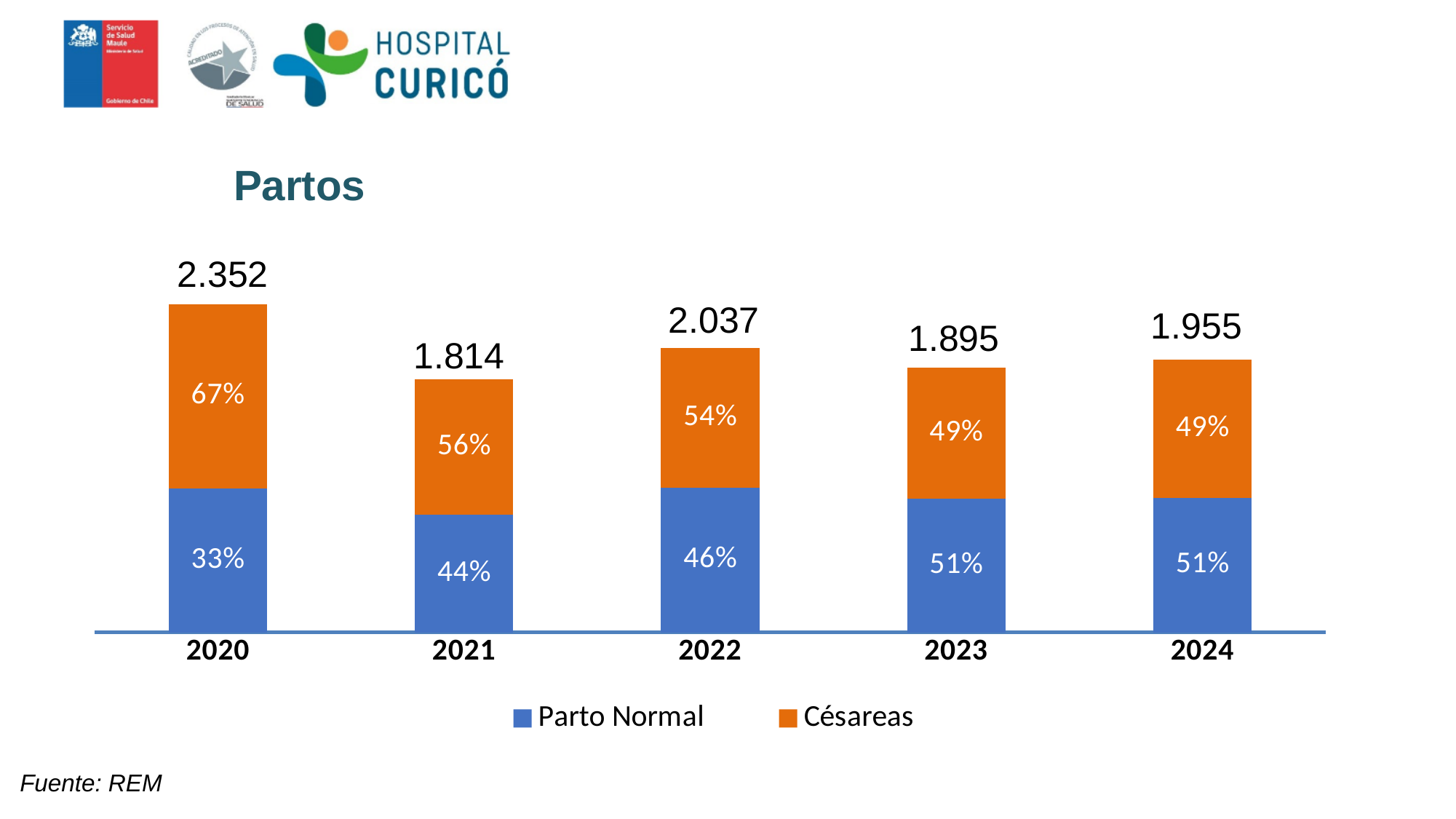
How many series does the legend list? 2 What kind of chart is shown on the slide? Stacked bar chart Which year has the lowest total number of partos? 2021 What percentage of partos in 2022 were Parto Normal? 46% What is the difference between the Césareas percentage and the Parto Normal percentage in 2020? 34% What is the total number of partos shown for 2024? 1.955 How many years are shown on the x axis? 5 What percentage of partos in 2021 were Césareas? 56% Does the Parto Normal percentage rise or fall from 2020 to 2023? Rise Which year has the highest total number of partos? 2020 What is the total number of partos shown for 2020? 2.352 In 2023, which is larger: the Parto Normal share or the Césareas share? Parto Normal